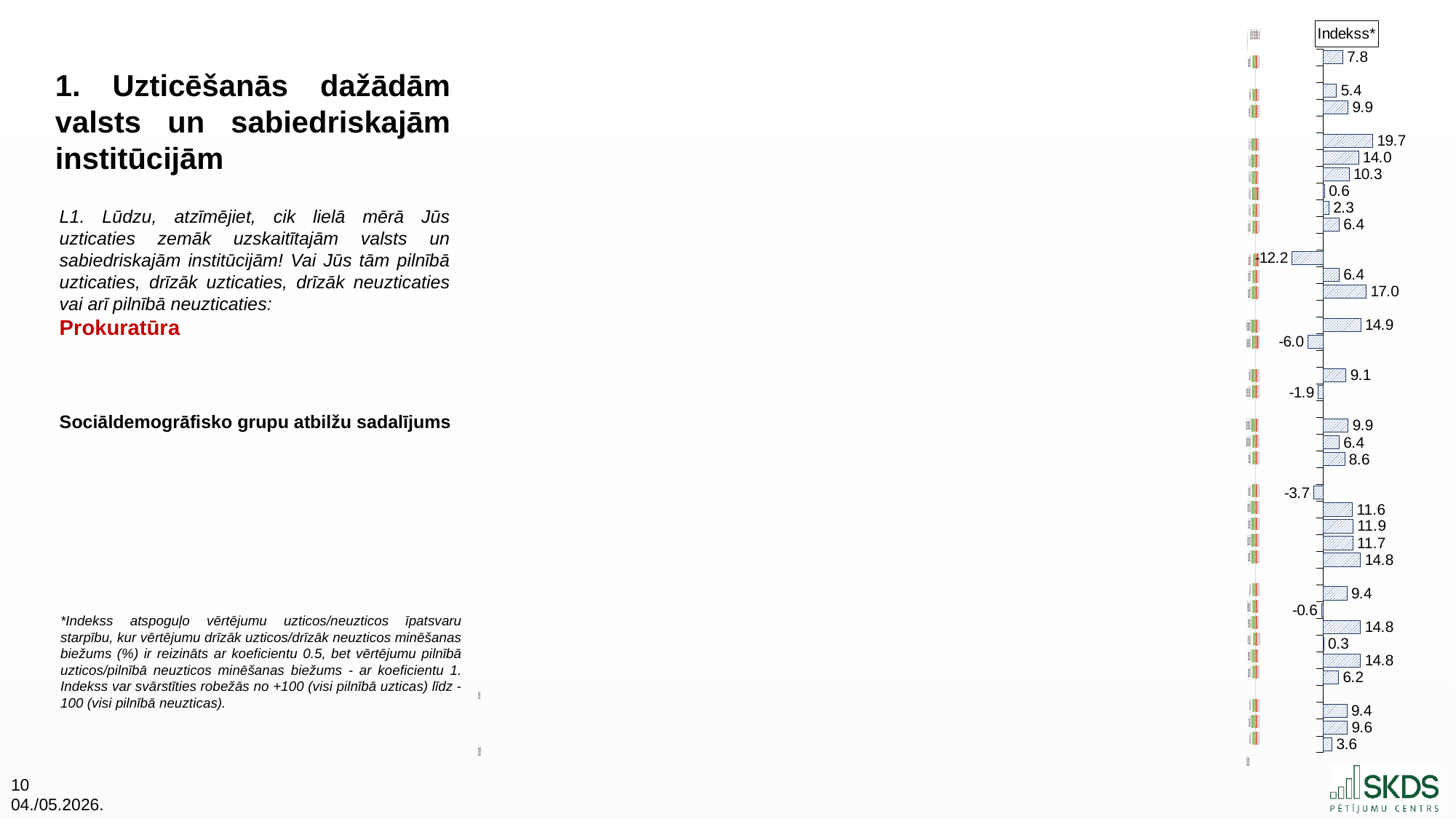
In the "Indekss*" bar chart, is the highest value greater or less than 15? greater In the "Indekss*" bar chart, what is the lowest value shown? -12.2 In the "Indekss*" bar chart, what is the difference between the highest value (19.7) and the lowest value (-12.2)? 31.9 In the "Indekss*" bar chart, how many bars have a negative value? 5 In the "Indekss*" bar chart, what is the value of the topmost bar? 7.8 In the "Indekss*" bar chart, how many bars are labelled 14.8? 3 In the "Indekss*" bar chart, what is the value of the bottommost bar? 3.6 What is the title shown above the bar chart on the right of the slide? Indekss* What kind of chart is the "Indekss*" chart on the right of the slide? bar chart In the "Indekss*" bar chart, what is the highest value shown? 19.7 In the "Indekss*" bar chart, which is larger: the bar labelled 17.0 or the bar labelled 14.9? 17.0 In the "Indekss*" bar chart, how many bars are plotted in total? 33